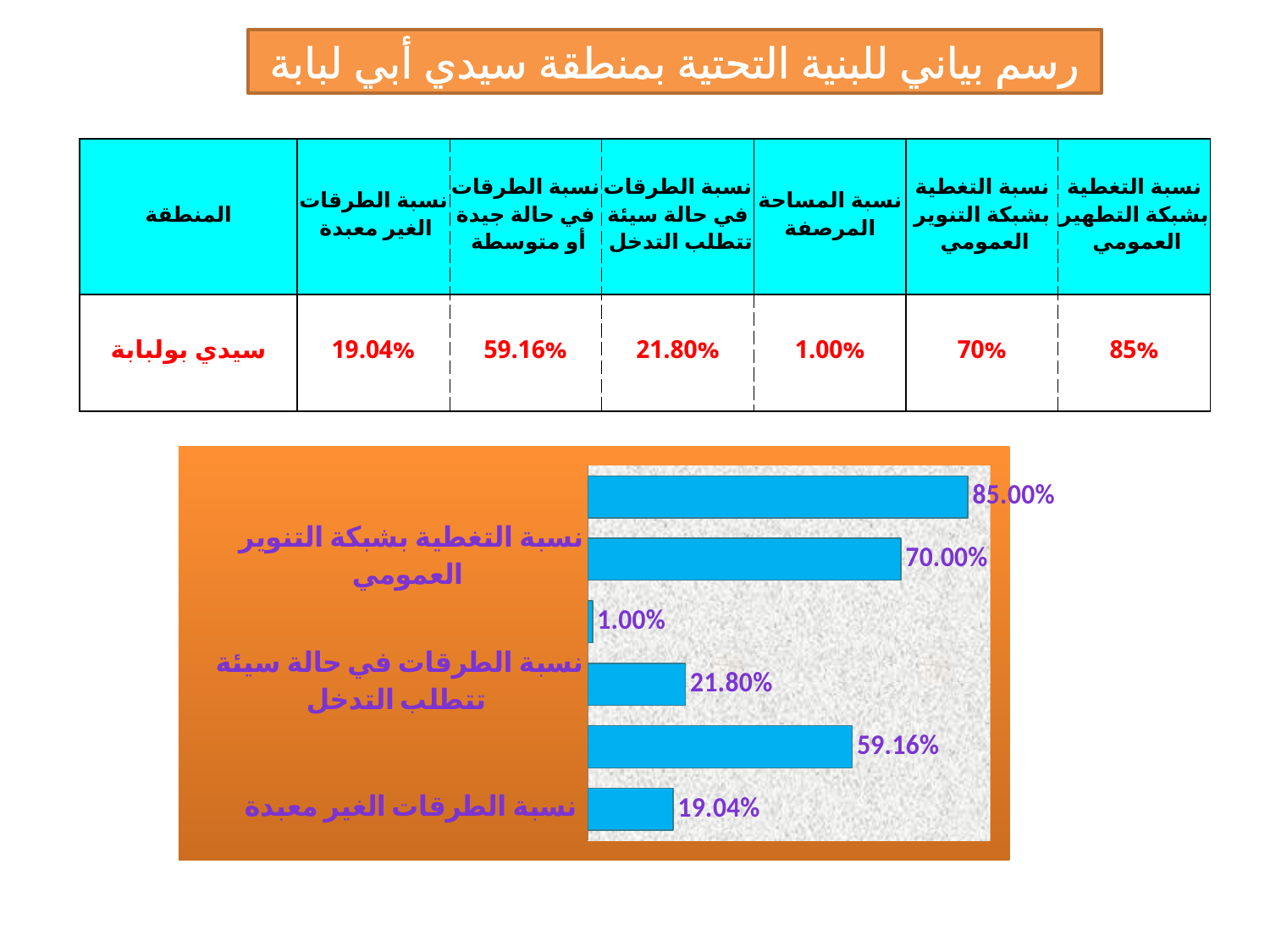
What is the difference between the value for نسبة التغطية بشبكة التنوير العمومي and the value for نسبة الطرقات الغير معبدة in the chart? 50.96% What is the largest value labelled on any bar in the chart? 85.00% What is the difference between the value for نسبة الطرقات في حالة سيئة تتطلب التدخل and the value for نسبة الطرقات الغير معبدة in the chart? 2.76% What is the value shown for نسبة التغطية بشبكة التنوير العمومي in the chart? 70.00% Which is larger in the chart: نسبة الطرقات في حالة سيئة تتطلب التدخل or نسبة الطرقات الغير معبدة? نسبة الطرقات في حالة سيئة تتطلب التدخل What is the value shown for نسبة الطرقات في حالة سيئة تتطلب التدخل in the chart? 21.80% What type of chart is shown on the slide? bar chart What colour are the bars in the chart? blue What is the value shown for نسبة الطرقات الغير معبدة in the chart? 19.04% How many bars are plotted in the chart? 6 What is the smallest value labelled on any bar in the chart? 1.00% Which of the three labelled categories in the chart has the highest value? نسبة التغطية بشبكة التنوير العمومي